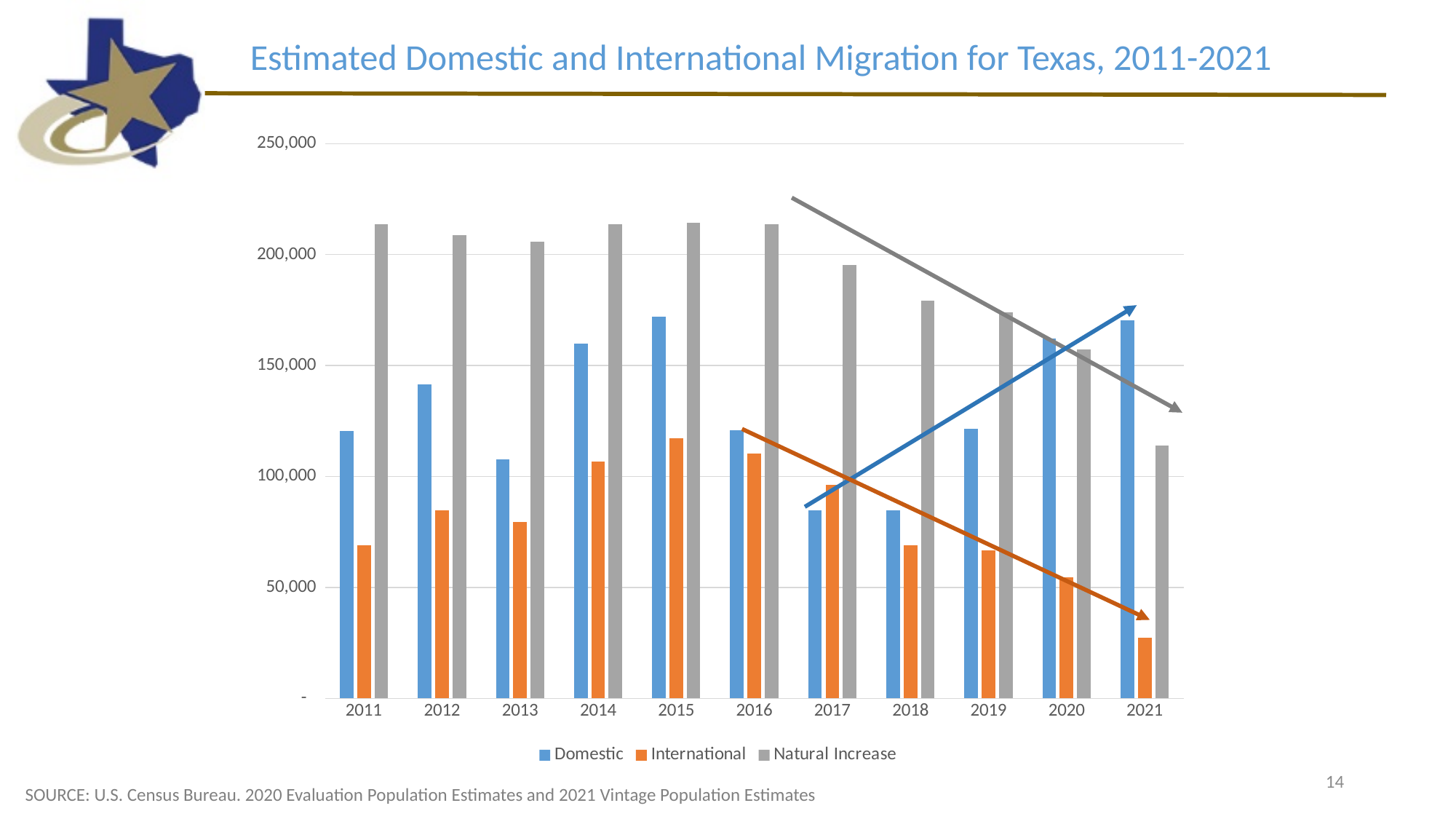
What kind of chart is shown on the slide? Bar chart Which year has the lowest International value? 2021 Is the International value for 2021 greater or less than 50,000? less How many years are shown on the x axis? 11 Is the Domestic value for 2017 greater or less than 100,000? less What is the title of the chart? Estimated Domestic and International Migration for Texas, 2011-2021 Which year has the highest International value? 2015 Is the Domestic value for 2014 greater or less than 150,000? greater Which year has the lowest Natural Increase value? 2021 In 2021, which is larger: the Domestic value or the Natural Increase value? Domestic How many series does the legend list? 3 Do the International values rise or fall from 2015 to 2021? Fall